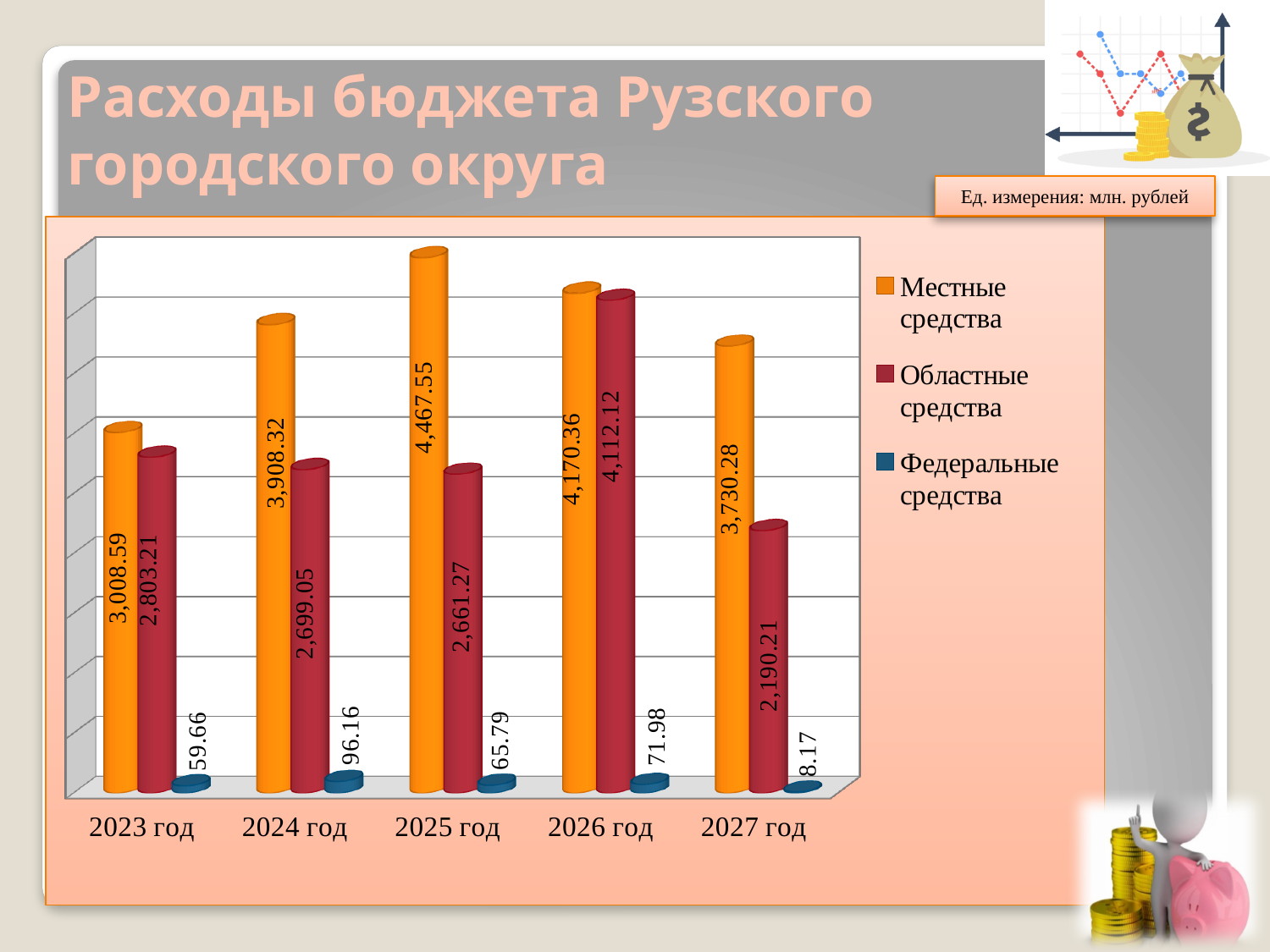
What is the value of Областные средства for 2026 год? 4,112.12 How many series does the legend list? 3 What is the difference between Местные средства and Областные средства in 2027 год? 1,540.07 What is the value of Областные средства for 2023 год? 2,803.21 In which year is the value of Местные средства the highest? 2025 год What is the value of Местные средства for 2025 год? 4,467.55 How many years are shown on the x axis? 5 Which is larger in 2024 год: Местные средства or Областные средства? Местные средства What is the value of Федеральные средства for 2027 год? 8.17 What kind of chart is shown on the slide? Bar chart In which year is the value of Федеральные средства the lowest? 2027 год What unit of measurement is stated on the slide for the chart values? млн. рублей